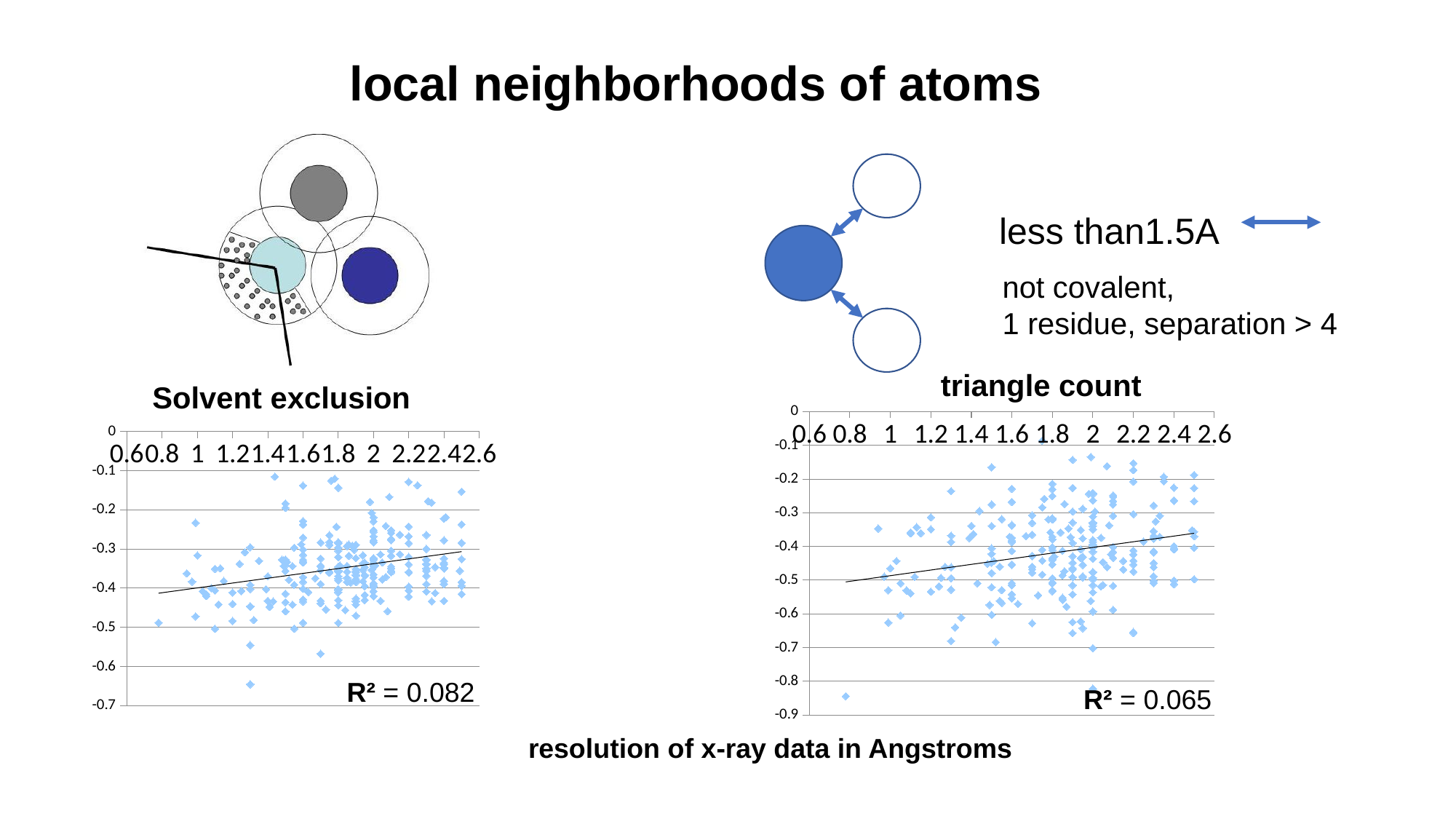
Which chart has the higher printed R² value, "Solvent exclusion" or "triangle count"? Solvent exclusion What is the x-axis label shared by the two charts? resolution of x-ray data in Angstroms In the "Solvent exclusion" chart, what R² value is printed for the trendline? 0.082 In the "triangle count" chart, does the fitted trendline rise or fall as the x-axis value increases? rise In the "triangle count" chart, what R² value is printed for the trendline? 0.065 What is the difference between the R² values printed on the "Solvent exclusion" and "triangle count" charts? 0.017 What is the lowest y-axis tick label shown on the "triangle count" chart? -0.9 In the "triangle count" chart, is the lowest plotted point greater or less than -0.8? less What kind of chart is the "Solvent exclusion" chart? scatter chart In the "Solvent exclusion" chart, is the lowest plotted point greater or less than -0.6? less In the "Solvent exclusion" chart, does the fitted trendline rise or fall as the x-axis value increases? rise What kind of chart is the "triangle count" chart? scatter chart